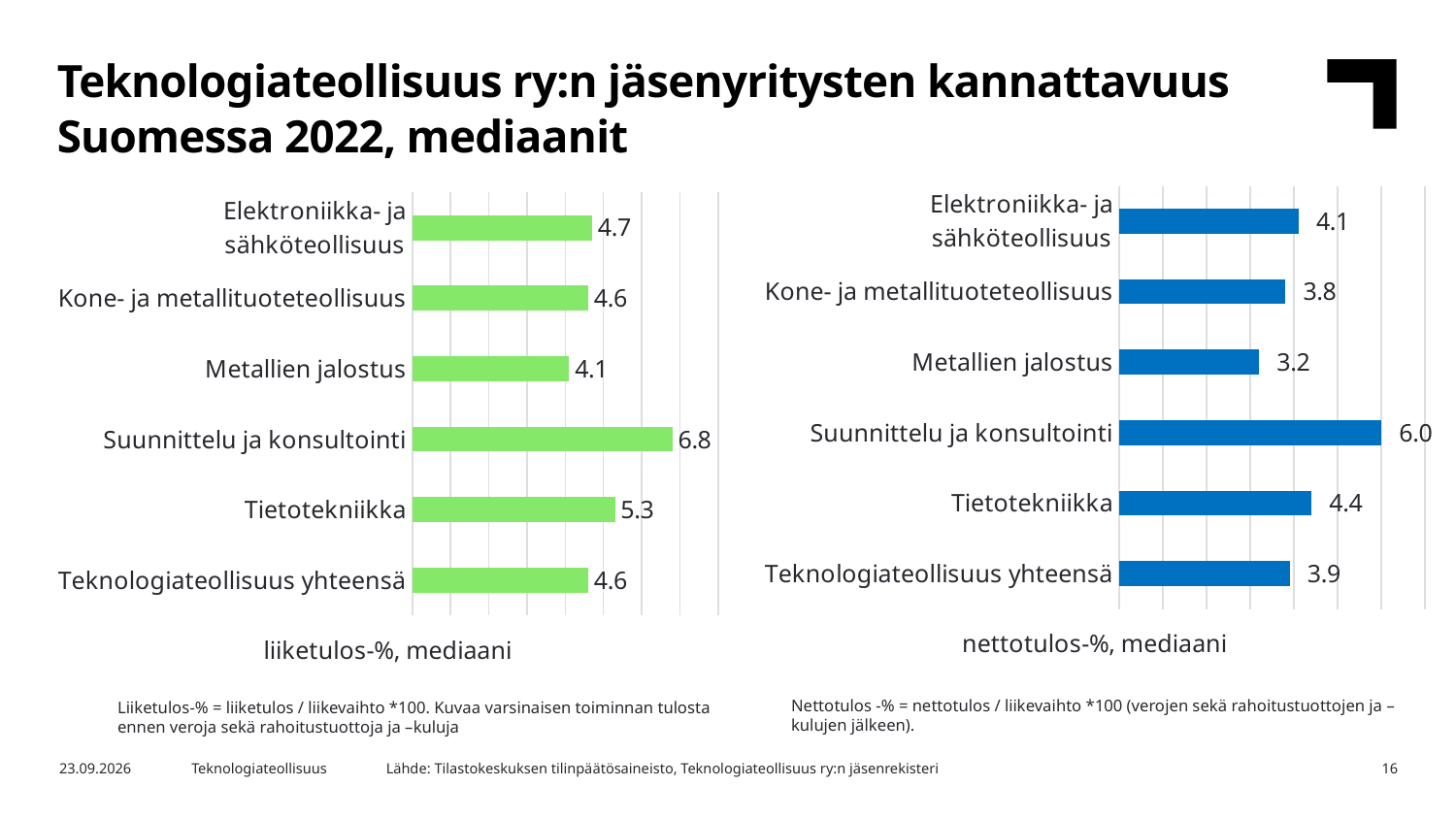
How many categories are shown in the liiketulos-%, mediaani chart? 6 In the liiketulos-%, mediaani chart, which is larger: Tietotekniikka or Metallien jalostus? Tietotekniikka In the nettotulos-%, mediaani chart, which category has the lowest value? Metallien jalostus In the liiketulos-%, mediaani chart, what is the value for Tietotekniikka? 5.3 In the nettotulos-%, mediaani chart, what is the value for Metallien jalostus? 3.2 In the nettotulos-%, mediaani chart, what is the difference between Tietotekniikka and Kone- ja metallituoteteollisuus? 0.6 In the nettotulos-%, mediaani chart, which is larger: Elektroniikka- ja sähköteollisuus or Teknologiateollisuus yhteensä? Elektroniikka- ja sähköteollisuus What colour are the bars in the nettotulos-%, mediaani chart? Blue What kind of chart is the nettotulos-%, mediaani chart? Bar chart In the liiketulos-%, mediaani chart, what is the difference between Suunnittelu ja konsultointi and Teknologiateollisuus yhteensä? 2.2 In the liiketulos-%, mediaani chart, which category has the highest value? Suunnittelu ja konsultointi In the liiketulos-%, mediaani chart, what is the value for Kone- ja metallituoteteollisuus? 4.6